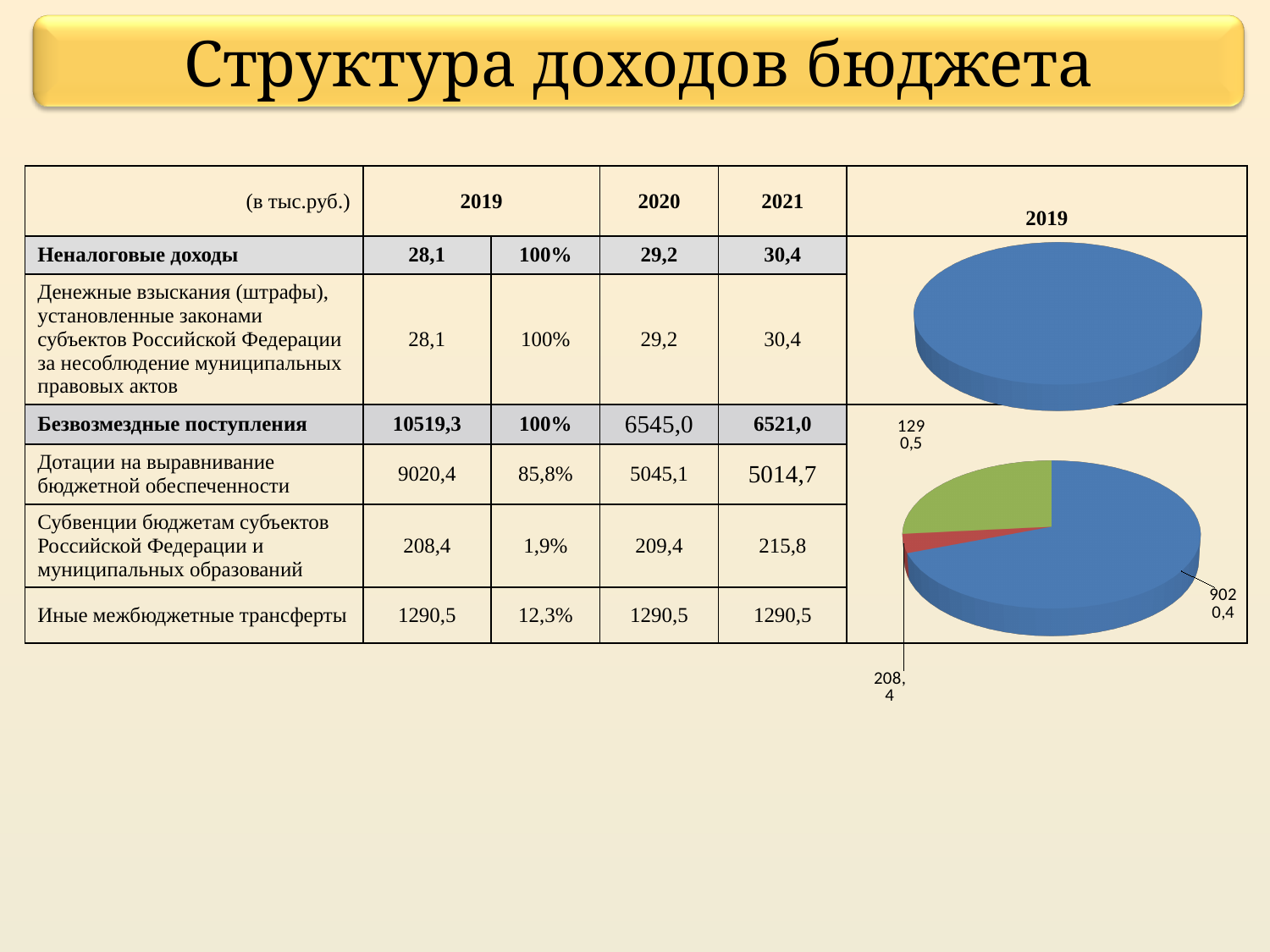
In the bottom pie chart, what is the difference between the largest slice (9020,4) and the green slice (1290,5)? 7729,9 In the bottom pie chart, what is the value of the largest slice? 9020,4 In the bottom pie chart, which slice is larger, the green one or the red one? The green one (1290,5) In the bottom pie chart, what is the value of the smallest slice? 208,4 What colour is the largest slice in the bottom pie chart? Blue How many slices does the top pie chart (titled 2019) have? 1 What is the title of the top pie chart on the right? 2019 What is the total of the three slice values shown in the bottom pie chart? 10519,3 In the bottom pie chart, what value is labelled on the green slice? 1290,5 What kind of chart is the top chart on the right side of the slide? Pie chart In the bottom pie chart, what is the difference between the green slice (1290,5) and the red slice (208,4)? 1082,1 How many slices does the bottom pie chart have? 3